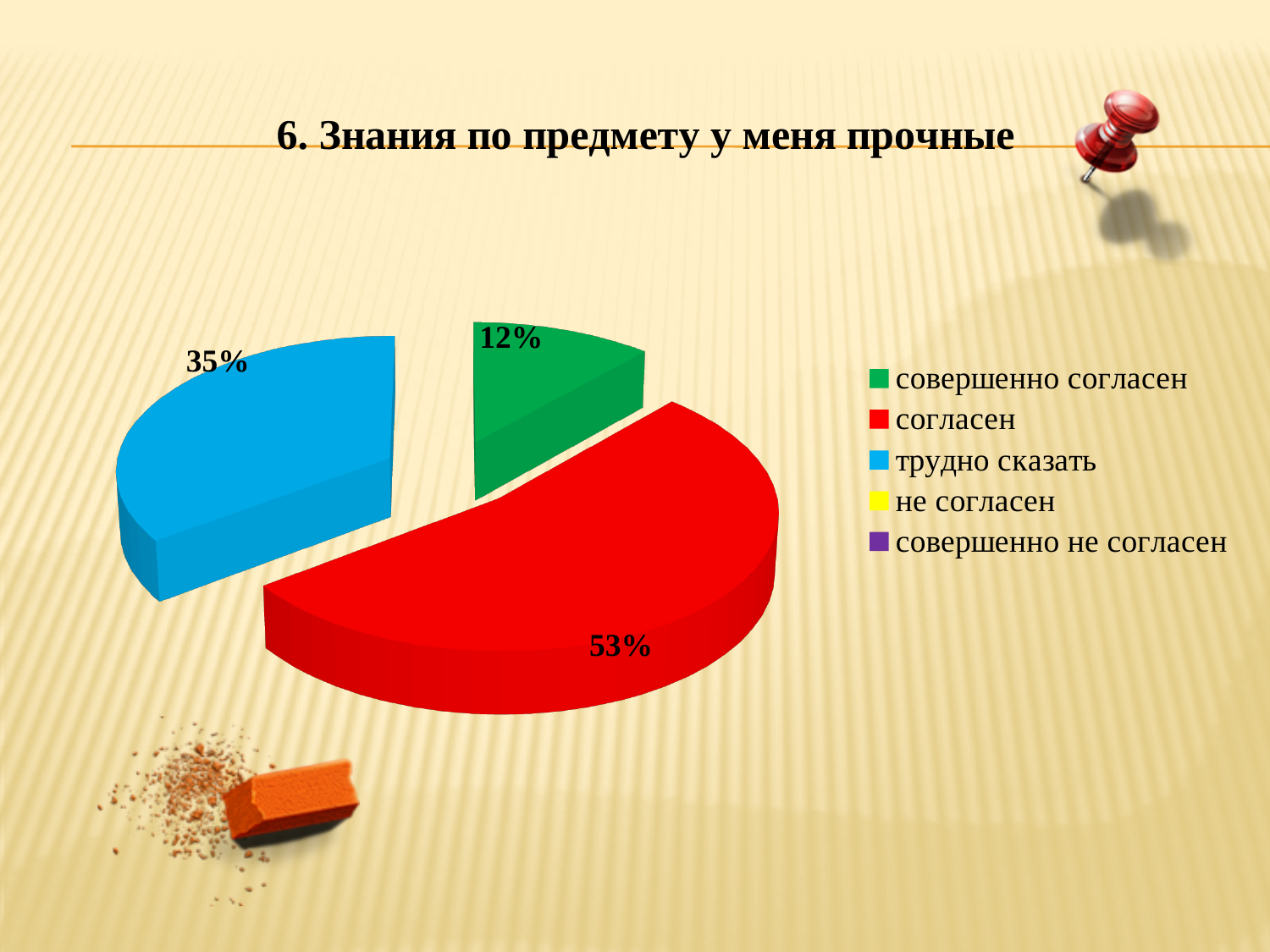
What share of the pie is labelled "трудно сказать"? 35% How many entries does the legend list? 5 What colour is the slice for "согласен"? red Which slice is larger: "трудно сказать" or "совершенно согласен"? трудно сказать What is the difference in percentage points between the "согласен" slice and the "трудно сказать" slice? 18 What is the title of the chart? 6. Знания по предмету у меня прочные What kind of chart is shown on the slide? pie chart What share of the pie is labelled "согласен"? 53% How many slices with a percentage label are visible in the pie? 3 Which category has the largest slice of the pie? согласен Which of the visible slices is the smallest? совершенно согласен What share of the pie is labelled "совершенно согласен"? 12%